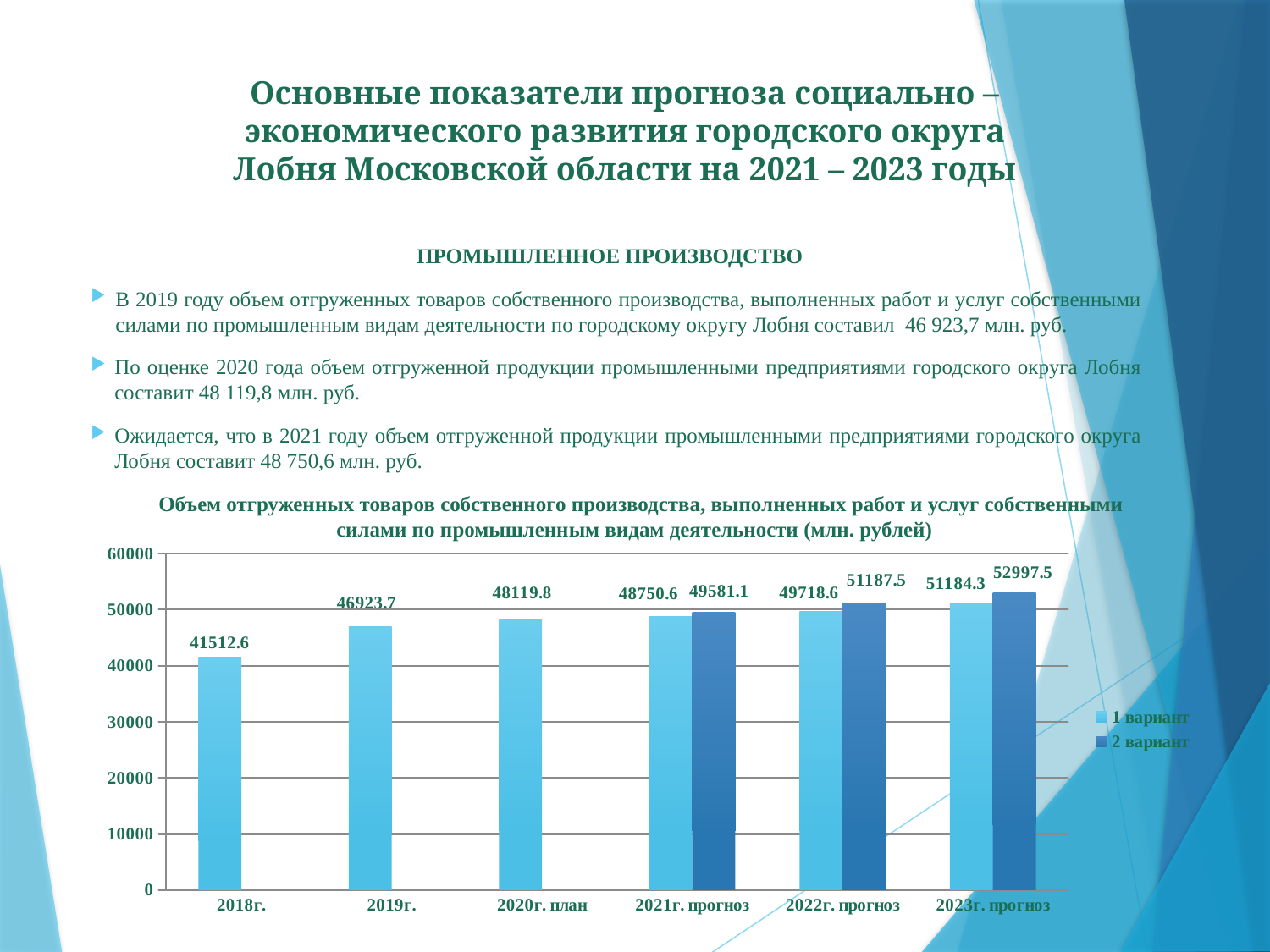
What is the value of the 1 вариант series for 2020г. план? 48119.8 How many categories are shown on the x axis of the chart? 6 Which bar has the highest value in the chart? 2 вариант for 2023г. прогноз What is the difference between the 2 вариант and 1 вариант values for 2022г. прогноз? 1468.9 What is the value of the 2 вариант series for 2021г. прогноз? 49581.1 What is the value for 2018г. in the chart? 41512.6 Which is larger: the 1 вариант value for 2021г. прогноз or the 1 вариант value for 2019г.? 2021г. прогноз How many series does the chart legend list? 2 What type of chart is shown on the slide? bar chart What is the value of the 2 вариант series for 2023г. прогноз? 52997.5 What is the difference between the 1 вариант values for 2019г. and 2018г.? 5411.1 Which category has the lowest value in the chart? 2018г.